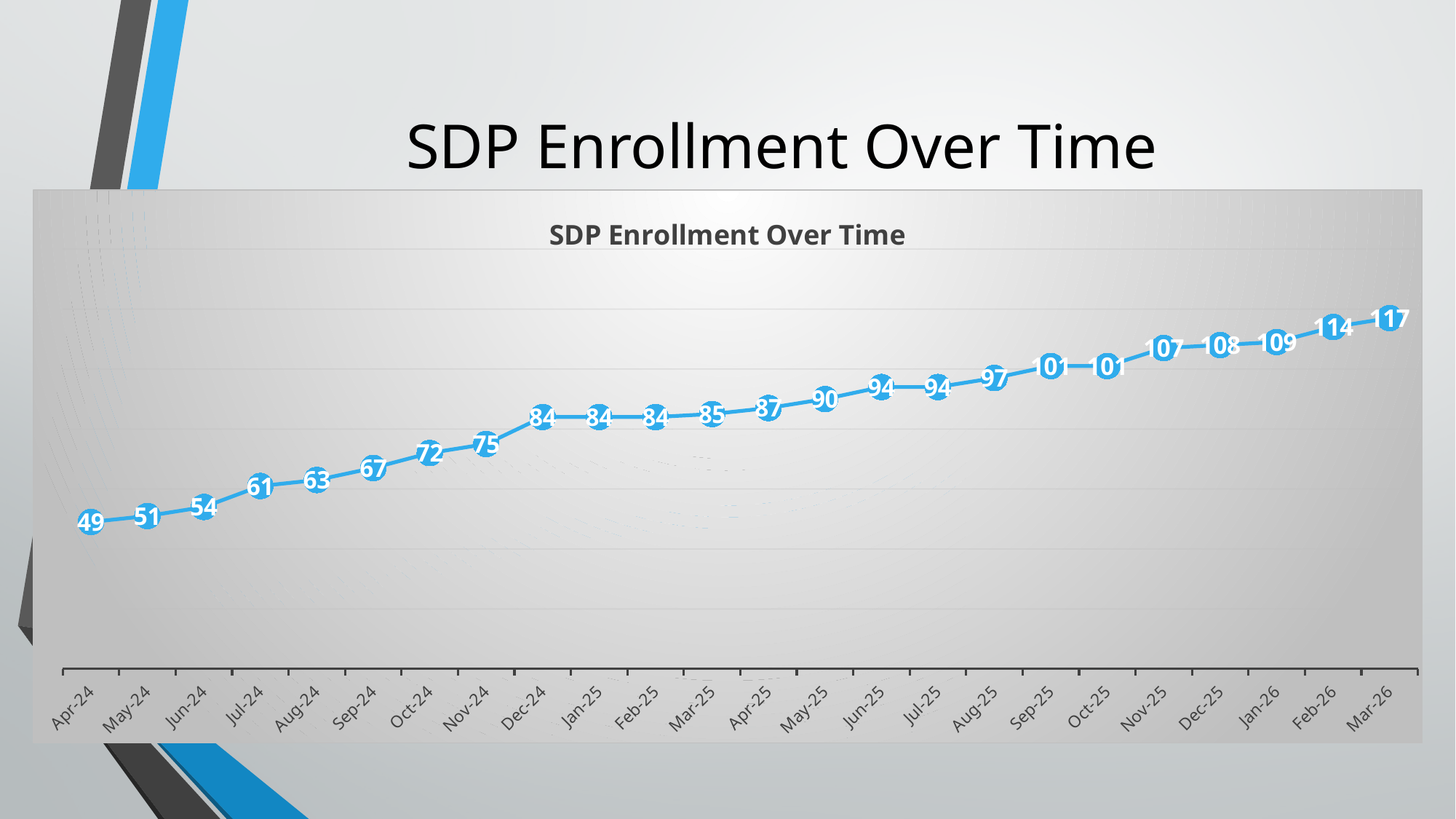
What is the SDP enrollment value for Apr-24? 49 What is the difference between the enrollment values for Mar-26 and Apr-24? 68 How many data points are plotted on the chart? 24 What is the difference between the enrollment values for Dec-24 and Nov-24? 9 Which month has the lowest enrollment value? Apr-24 What is the SDP enrollment value for Mar-26? 117 What is the SDP enrollment value for Dec-24? 84 What type of chart is shown on the slide? line chart Do the enrollment values generally rise or fall from Apr-24 to Mar-26? rise Which has a larger enrollment value, Jul-24 or Oct-24? Oct-24 Which month has the highest enrollment value? Mar-26 What is the SDP enrollment value for Nov-25? 107